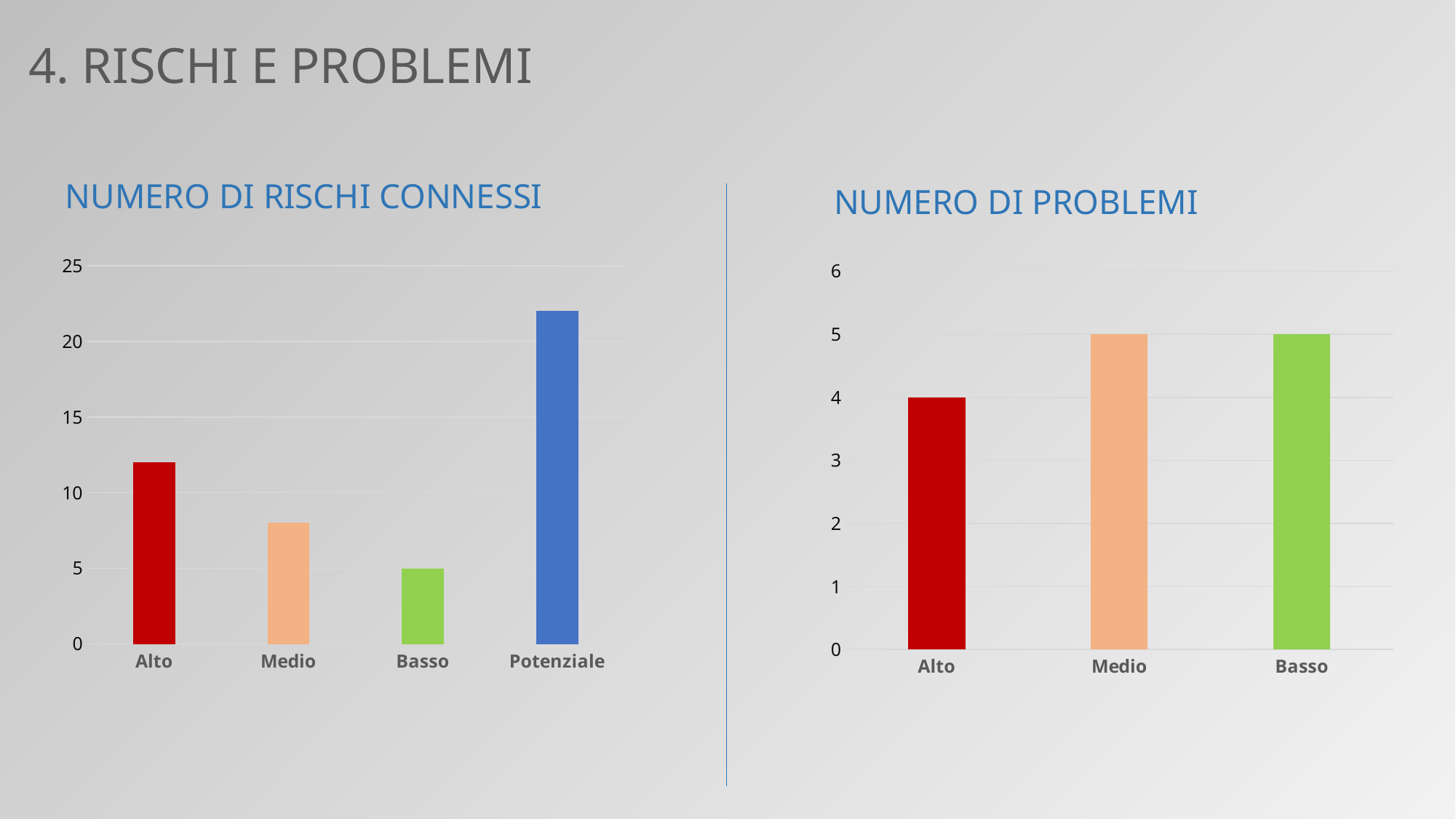
In the NUMERO DI RISCHI CONNESSI chart, what is the value for Basso? 5 In the NUMERO DI PROBLEMI chart, what is the value for Alto? 4 In the NUMERO DI RISCHI CONNESSI chart, which category has the lowest value? Basso In the NUMERO DI RISCHI CONNESSI chart, is the value for Medio greater or less than 10? less In the NUMERO DI PROBLEMI chart, what is the value for Medio? 5 In the NUMERO DI PROBLEMI chart, which category has the lowest value? Alto What kind of chart is the NUMERO DI RISCHI CONNESSI chart? Bar chart In the NUMERO DI PROBLEMI chart, how many categories are shown? 3 In the NUMERO DI RISCHI CONNESSI chart, is the value for Potenziale greater or less than 20? greater In the NUMERO DI RISCHI CONNESSI chart, which is larger, the value for Alto or the value for Medio? Alto In the NUMERO DI PROBLEMI chart, what is the difference between the values for Medio and Alto? 1 In the NUMERO DI RISCHI CONNESSI chart, which category has the highest value? Potenziale